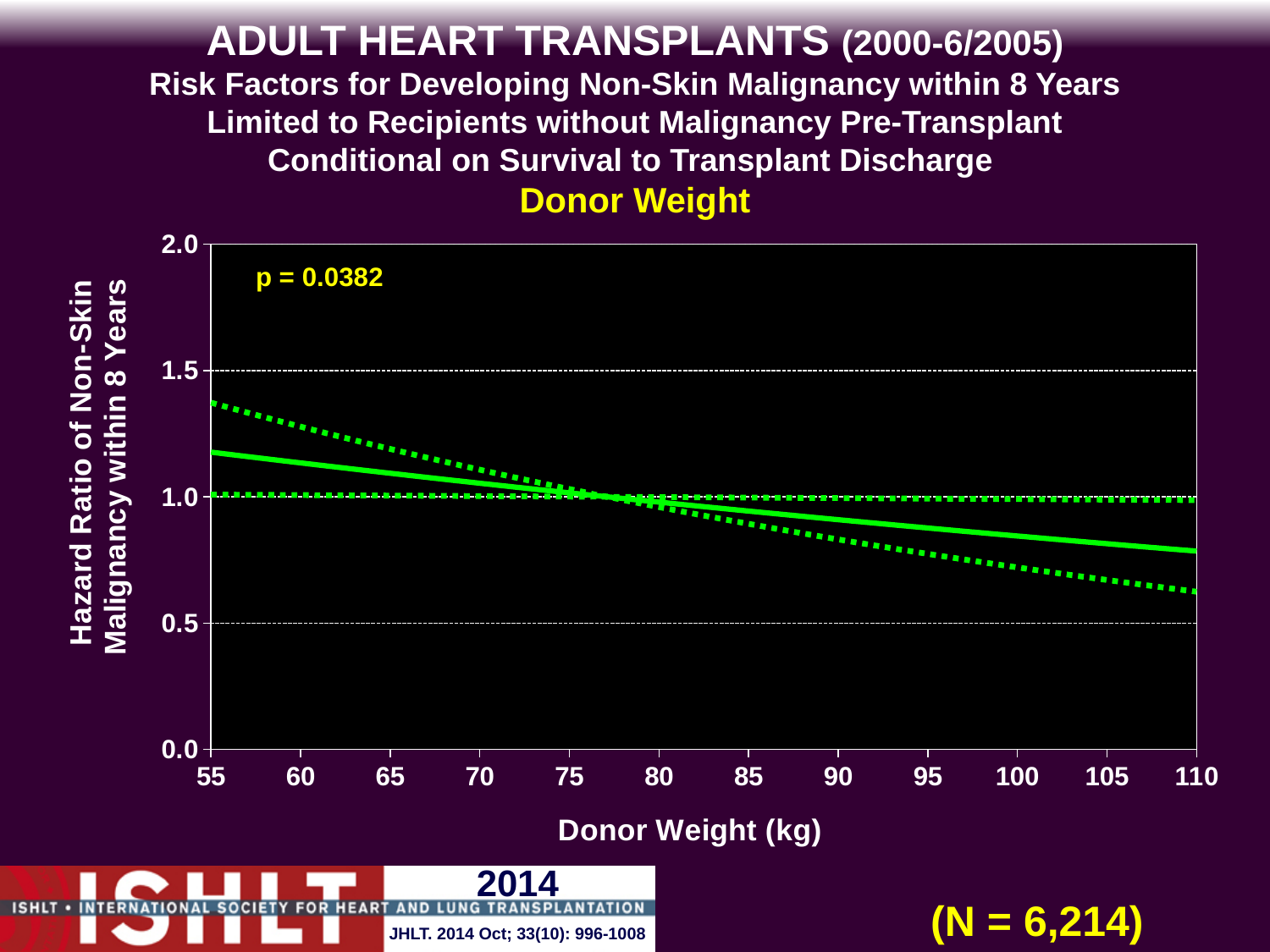
Is the value of the solid hazard ratio line at a donor weight of 110 kg greater or less than 1.0? less Does the solid hazard ratio line rise or fall as donor weight increases from 55 kg to 110 kg? fall How many tick labels are shown on the x axis (Donor Weight)? 12 How many lines are plotted on the chart? 3 What p-value is printed on the chart? p = 0.0382 What sample size (N) is shown on the slide? N = 6,214 What kind of chart is shown on the slide? line chart Is the lower dotted line at a donor weight of 110 kg greater or less than 0.5? greater What is the highest value shown on the y axis? 2.0 Is the upper dotted line at a donor weight of 55 kg greater or less than 1.5? less What is the lowest donor weight shown on the x axis? 55